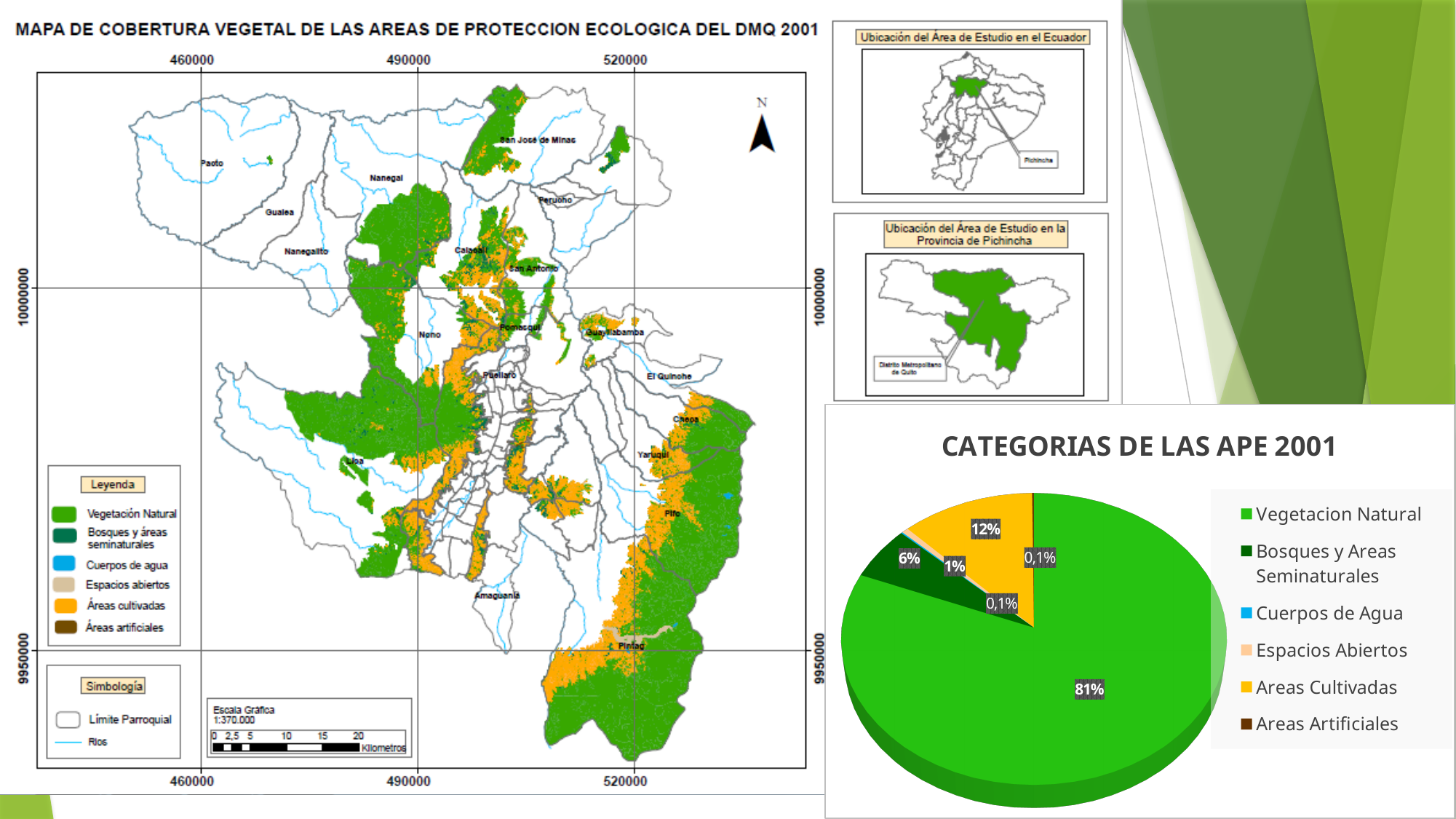
In the pie chart, which is larger: Areas Cultivadas or Bosques y Areas Seminaturales? Areas Cultivadas What kind of chart is shown on the right side of the slide? pie chart In the pie chart, what percentage is shown for Bosques y Areas Seminaturales? 6% In the pie chart, what colour is the slice for Areas Cultivadas? yellow In the pie chart, what percentage is shown for Areas Cultivadas? 12% Which category has the largest slice in the pie chart? Vegetacion Natural In the pie chart, what percentage is shown for Espacios Abiertos? 1% In the pie chart, what percentage is shown for Areas Artificiales? 0,1% What is the title of the pie chart? CATEGORIAS DE LAS APE 2001 How many categories does the legend of the pie chart list? 6 In the pie chart, what is the difference between the shares of Vegetacion Natural and Areas Cultivadas? 69% In the pie chart, what share does Vegetacion Natural have? 81%